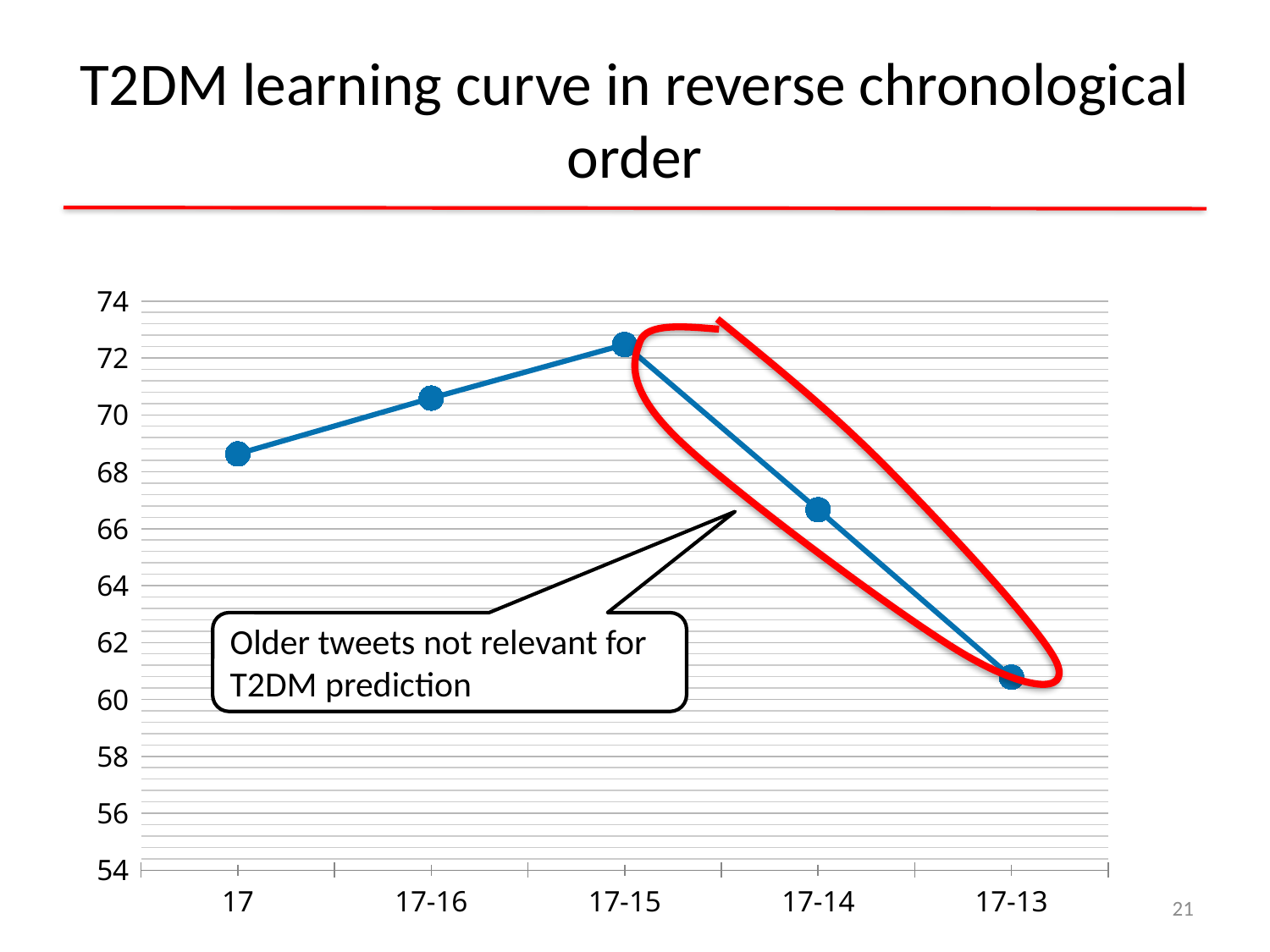
How many data points are plotted on the line? 5 Which has the larger value, 17-16 or 17-14? 17-16 What kind of chart is shown on the slide? line chart What does the callout box on the chart say? Older tweets not relevant for T2DM prediction Does the line rise or fall between 17-15 and 17-13? fall Which category has the highest value on the line? 17-15 Which category has the lowest value on the line? 17-13 Is the value for 17 greater or less than 70? less Is the value for 17-15 greater or less than 72? greater Is the value for 17-14 greater or less than 66? greater Which has the larger value, 17 or 17-13? 17